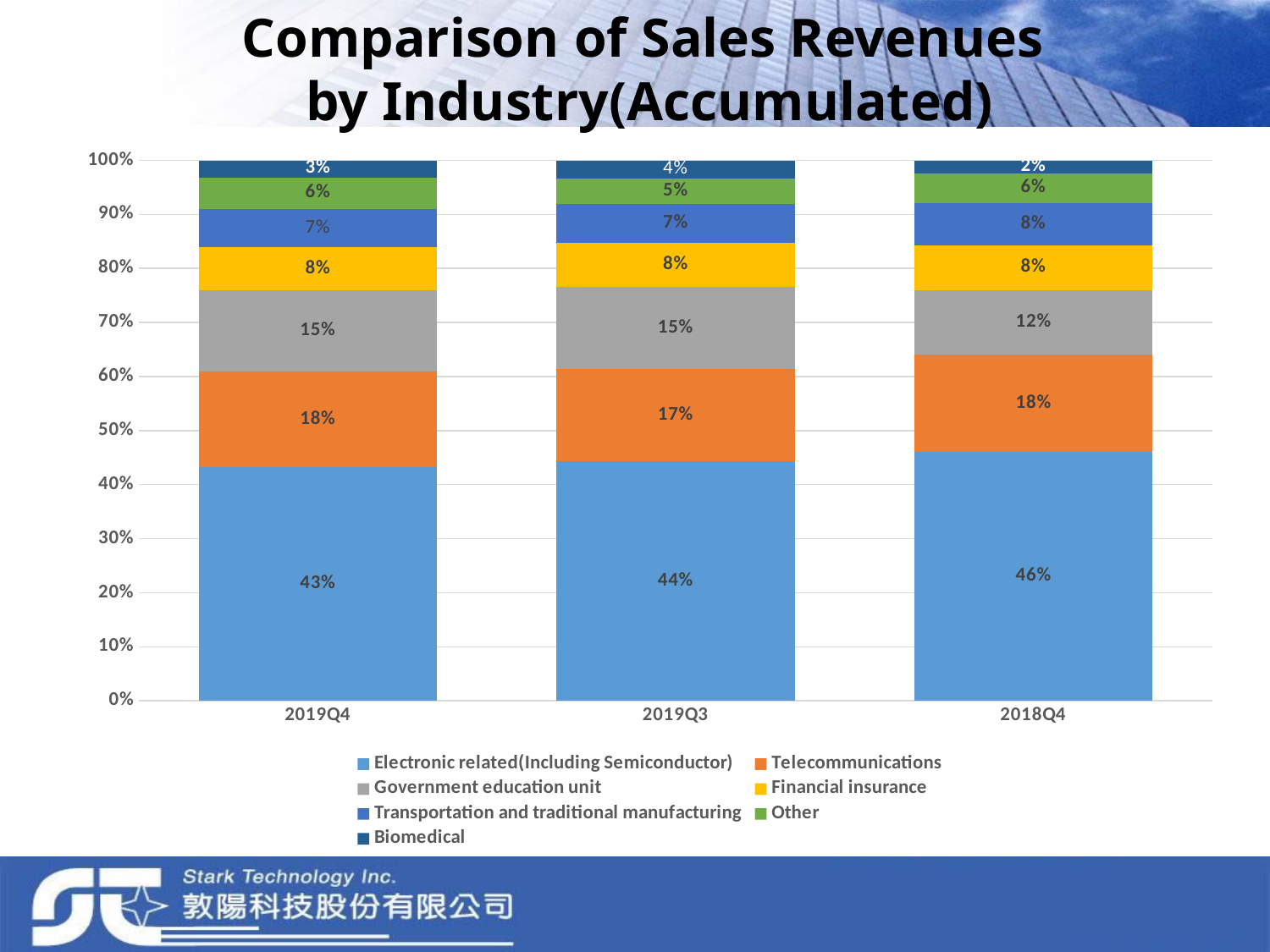
In which period was the Electronic related(Including Semiconductor) share highest? 2018Q4 How many periods are shown on the x axis? 3 Which is larger in 2019Q4: the Telecommunications share or the Government education unit share? Telecommunications What is the Telecommunications share in 2019Q3? 17% Which series is shown in orange in the legend? Telecommunications What kind of chart is shown on the slide? Stacked bar chart In which period was the Biomedical share lowest? 2018Q4 What is the Government education unit share in 2018Q4? 12% What share of sales revenue did Electronic related(Including Semiconductor) account for in 2019Q4? 43% What is the difference between the Government education unit share in 2019Q4 and in 2018Q4? 3% What is the Biomedical share in 2018Q4? 2% How many series does the legend list? 7